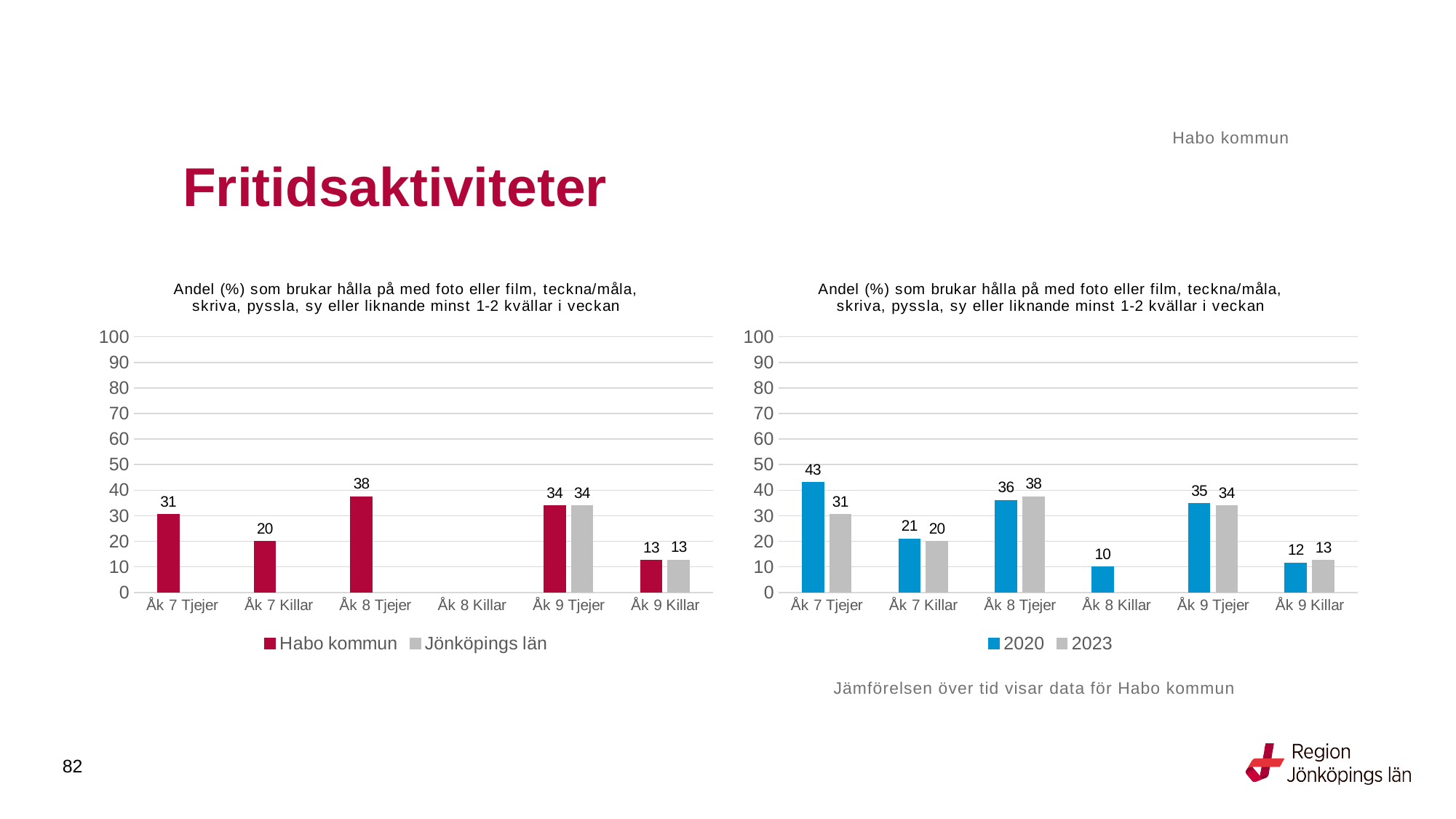
How many categories are shown on the x axis of the right chart? 6 In the right chart, what is the difference between the 2020 and 2023 values for Åk 7 Tjejer? 12 In the left chart, which category has the highest Habo kommun value? Åk 8 Tjejer In the right chart, which is larger for Åk 8 Tjejer, the 2020 value or the 2023 value? 2023 In the left chart, what is the value for Habo kommun for Åk 7 Tjejer? 31 What type of chart is the left chart? Bar chart In the left chart, what is the value for Habo kommun for Åk 8 Tjejer? 38 In the right chart, what is the 2020 value for Åk 7 Tjejer? 43 In the left chart, how many series does the legend list? 2 In the left chart, what is the difference between the Habo kommun values for Åk 7 Tjejer and Åk 7 Killar? 11 In the right chart, which category has the lowest 2023 value? Åk 9 Killar